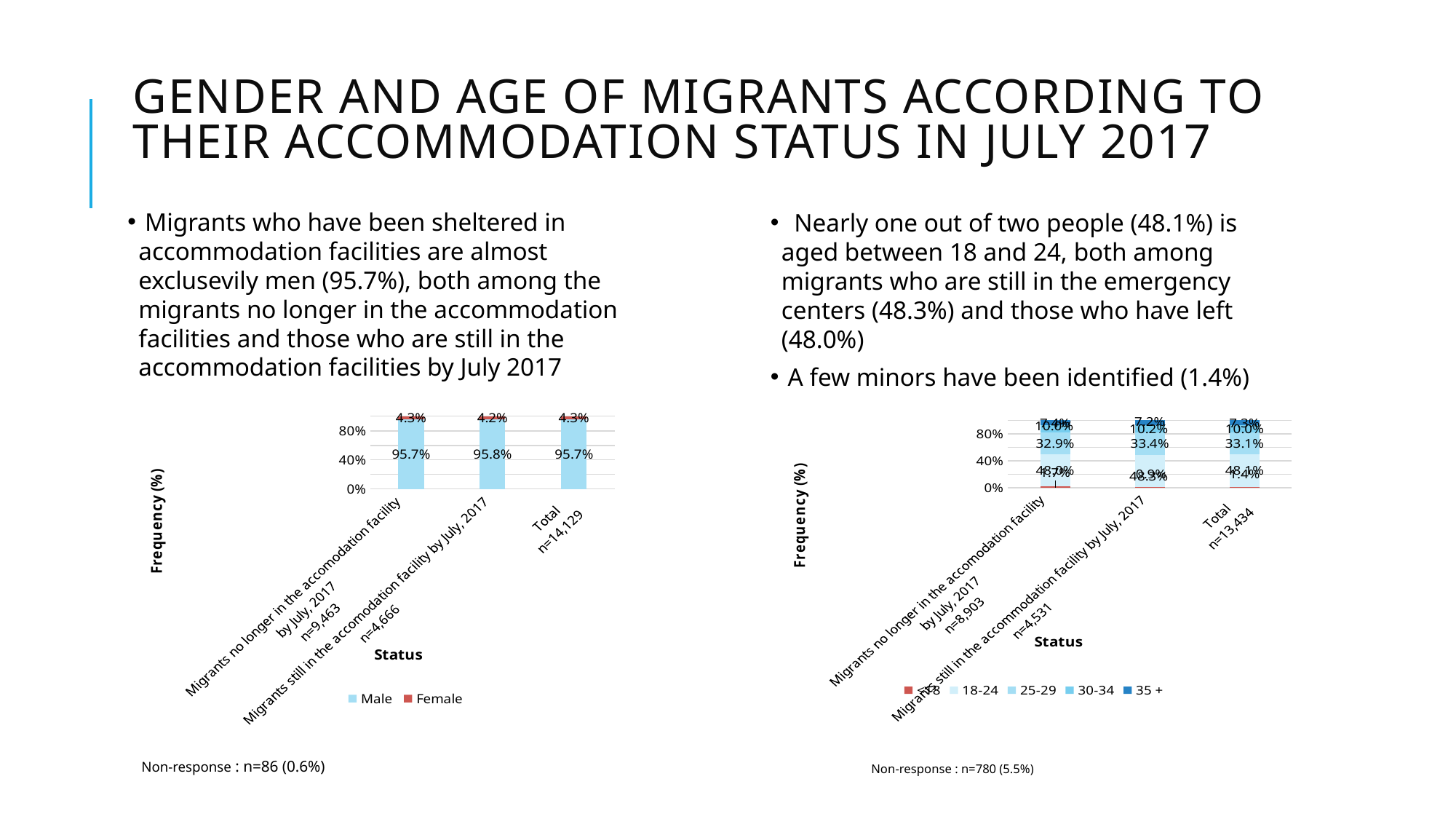
In the right chart (age), what is the 30-34 value for migrants still in the accommodation facility by July 2017? 10.2% In the right chart (age), what is the 25-29 value for migrants still in the accommodation facility by July 2017? 33.4% In the left chart (gender), how many categories are shown on the x axis? 3 What kind of chart is the left chart (gender)? Stacked bar chart In the left chart (gender), how many series does the legend list? 2 In the left chart (gender), what is the Male value for the Total category? 95.7% In the left chart (gender), what is the difference between the Male and Female values for migrants still in the accommodation facility by July 2017? 91.6% In the left chart (gender), what is the Male value for migrants no longer in the accommodation facility by July 2017? 95.7% In the left chart (gender), which category has the highest Male value? Migrants still in the accommodation facility by July, 2017 In the right chart (age), how many series does the legend list? 5 In the right chart (age), what is the 25-29 value for the Total category? 33.1% In the left chart (gender), what is the Female value for migrants still in the accommodation facility by July 2017? 4.2%